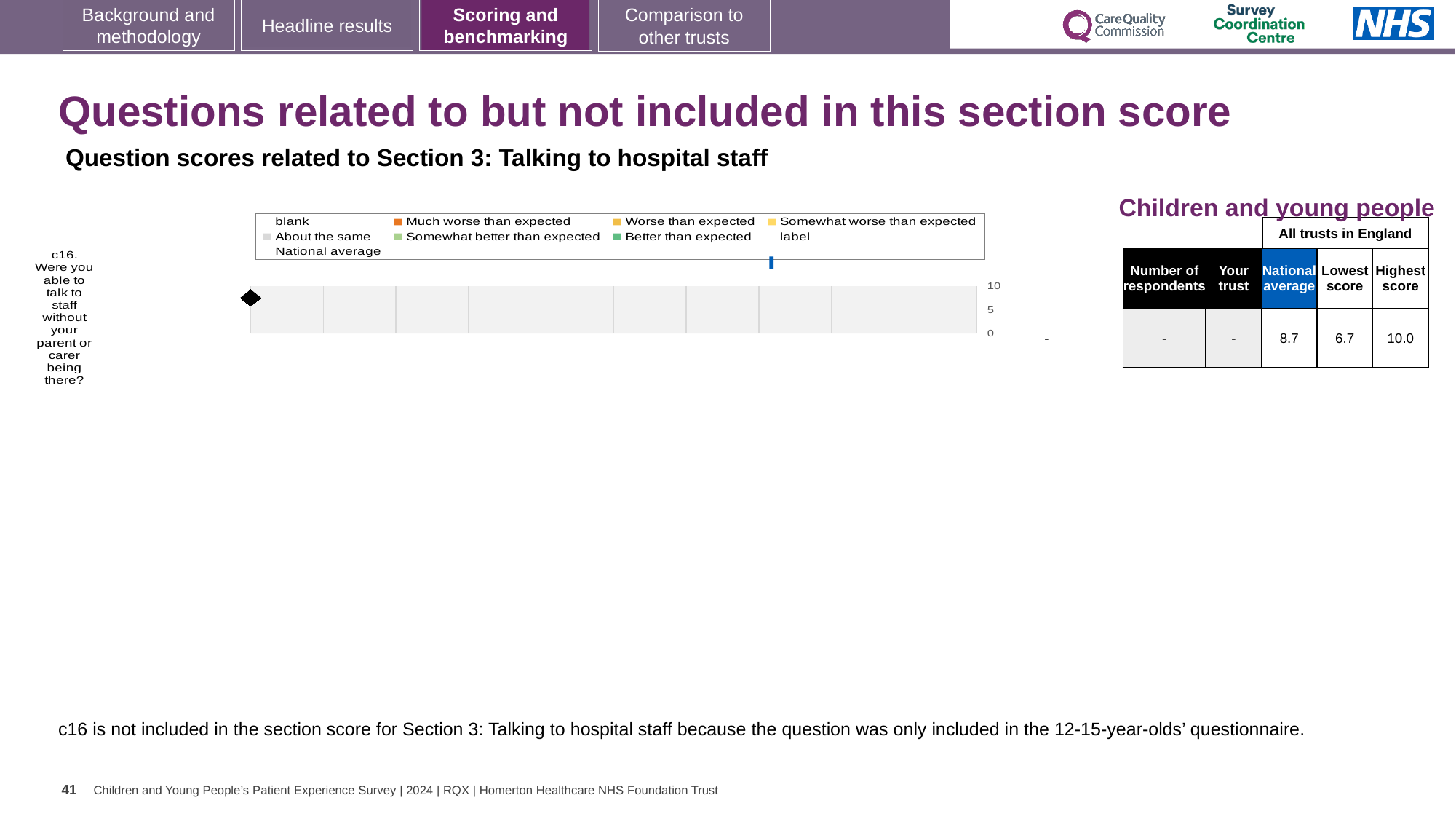
In the table to the right of the chart, what value is shown for Your trust for c16? - What is the label of the single category on the chart's y axis? c16. Were you able to talk to staff without your parent or carer being there? What is the highest tick value shown on the chart's value axis? 10 In the table to the right of the chart, what is the National average score for c16? 8.7 How many question categories are plotted on the chart? 1 In the table to the right of the chart, what is the Highest score among all trusts in England for c16? 10.0 In the table to the right of the chart, which is larger for c16: the National average or the Lowest score? National average What kind of chart is shown on the slide? bar chart In the table to the right of the chart, what is the difference between the Highest score and the Lowest score for c16? 3.3 In the table to the right of the chart, what is the Lowest score among all trusts in England for c16? 6.7